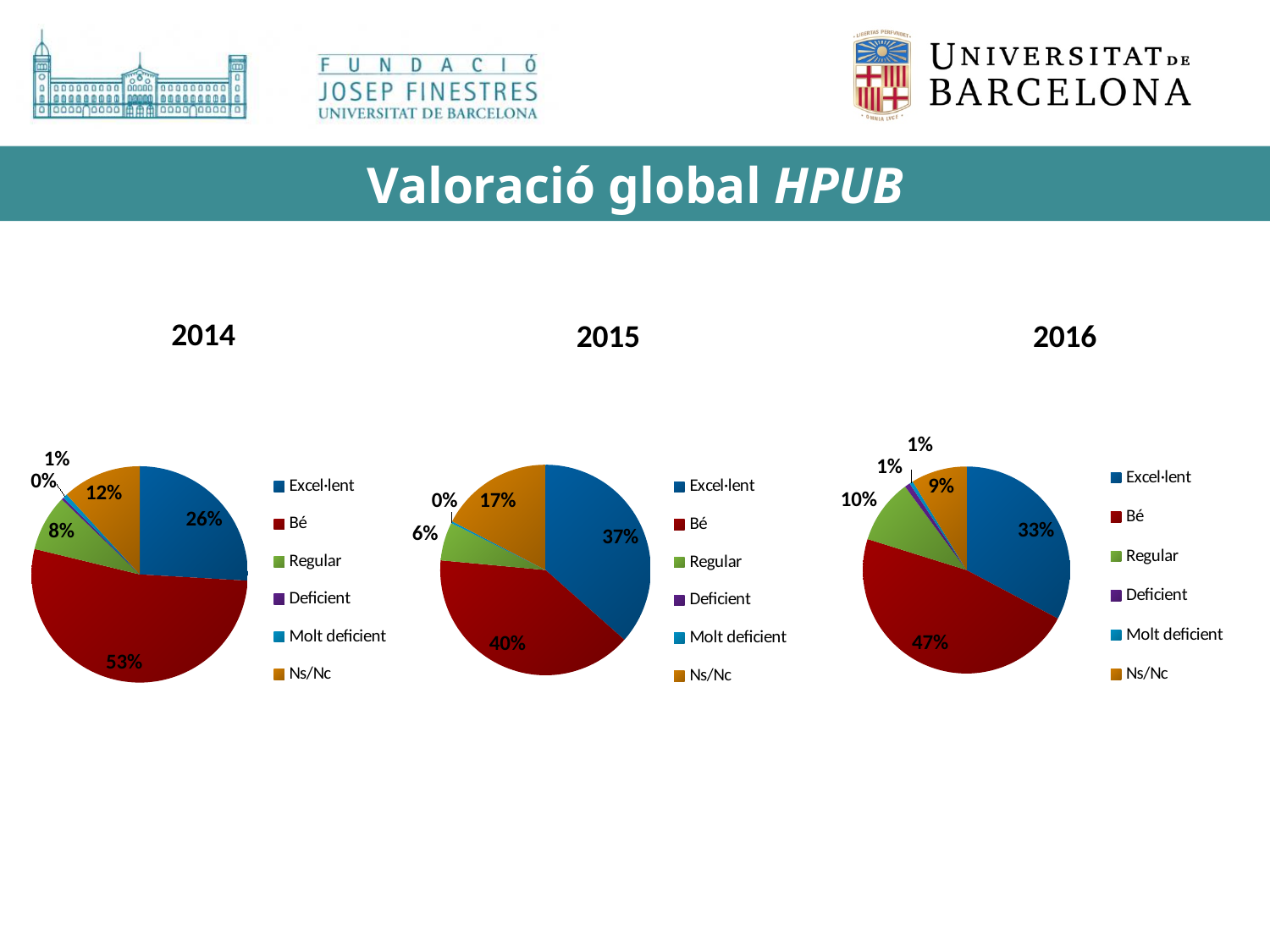
In the 2015 pie chart, which category has the largest slice? Bé In the 2015 pie chart, what share is labelled for Excel·lent? 37% In the 2014 pie chart, what share is labelled for Bé? 53% How many entries does the legend of the 2016 pie chart list? 6 In the 2015 pie chart, what is the difference between the Bé and Excel·lent shares? 3% In the 2016 pie chart, what share is labelled for Regular? 10% In the 2016 pie chart, what share is labelled for Ns/Nc? 9% In the 2014 pie chart, which is larger, the Ns/Nc slice or the Regular slice? Ns/Nc In the 2014 pie chart, which category has the largest slice? Bé In the 2016 pie chart, which category has the largest slice? Bé What type of chart is used for the 2014 data? Pie chart How many charts are shown on the slide? 3